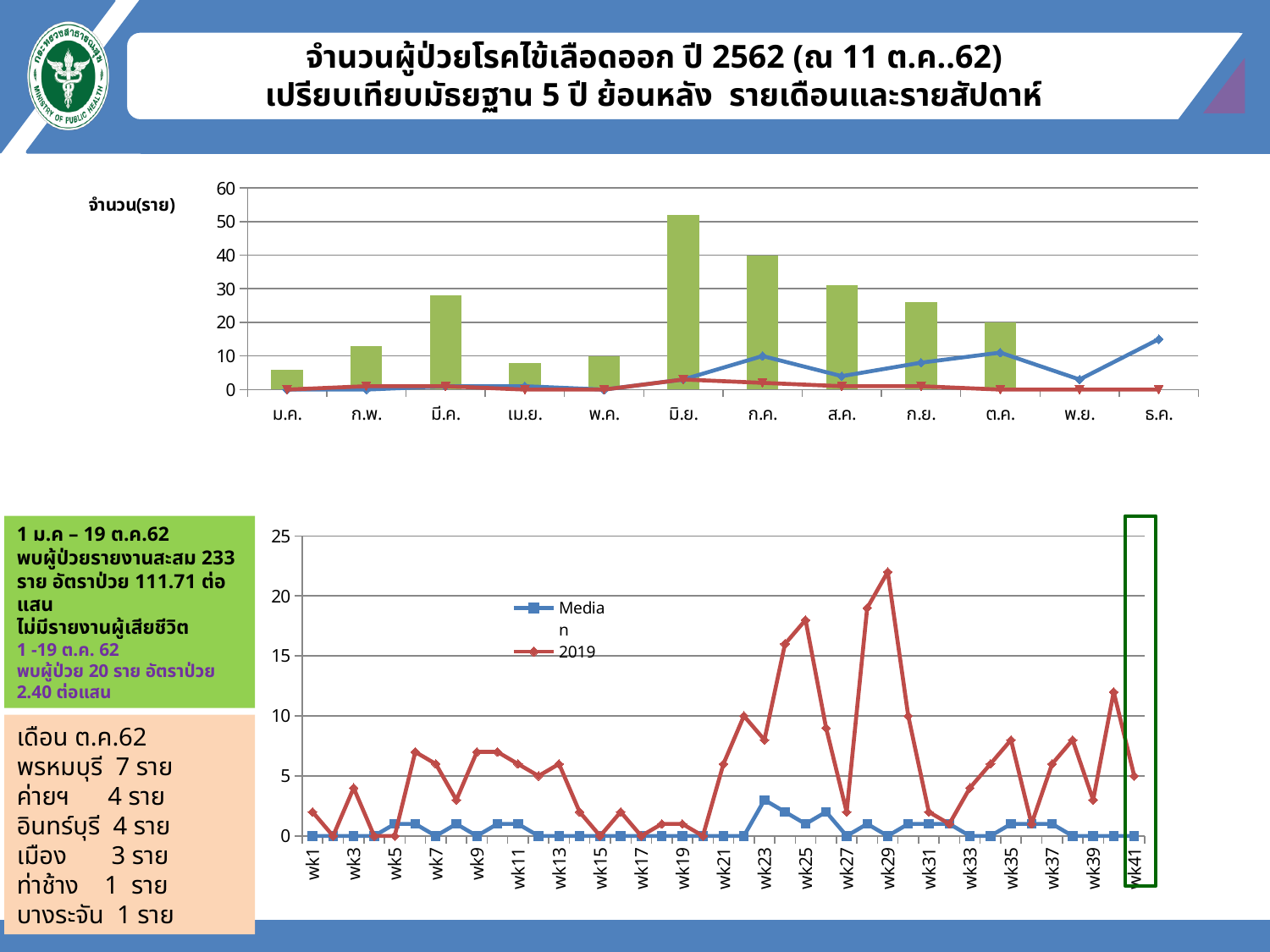
In the bottom chart, which is larger for the 2019 series, the value at wk23 or at wk25? wk25 In the bottom chart, what kind of chart is it? line chart In the bottom chart, at which week does the 2019 series reach its highest value? wk29 In the top chart, is the bar for ม.ค. greater or less than 10? less In the top chart, which month has the tallest bar? มิ.ย. In the top chart, how many month categories are shown on the x axis? 12 In the top chart, is the bar for ก.ค. greater or less than 30? greater In the top chart, what kind of chart is used for the green series? bar chart In the bottom chart, how many series does the legend list? 2 In the top chart, which bar is taller, ก.ค. or ส.ค.? ก.ค. In the top chart, is the bar for มี.ค. greater or less than 20? greater